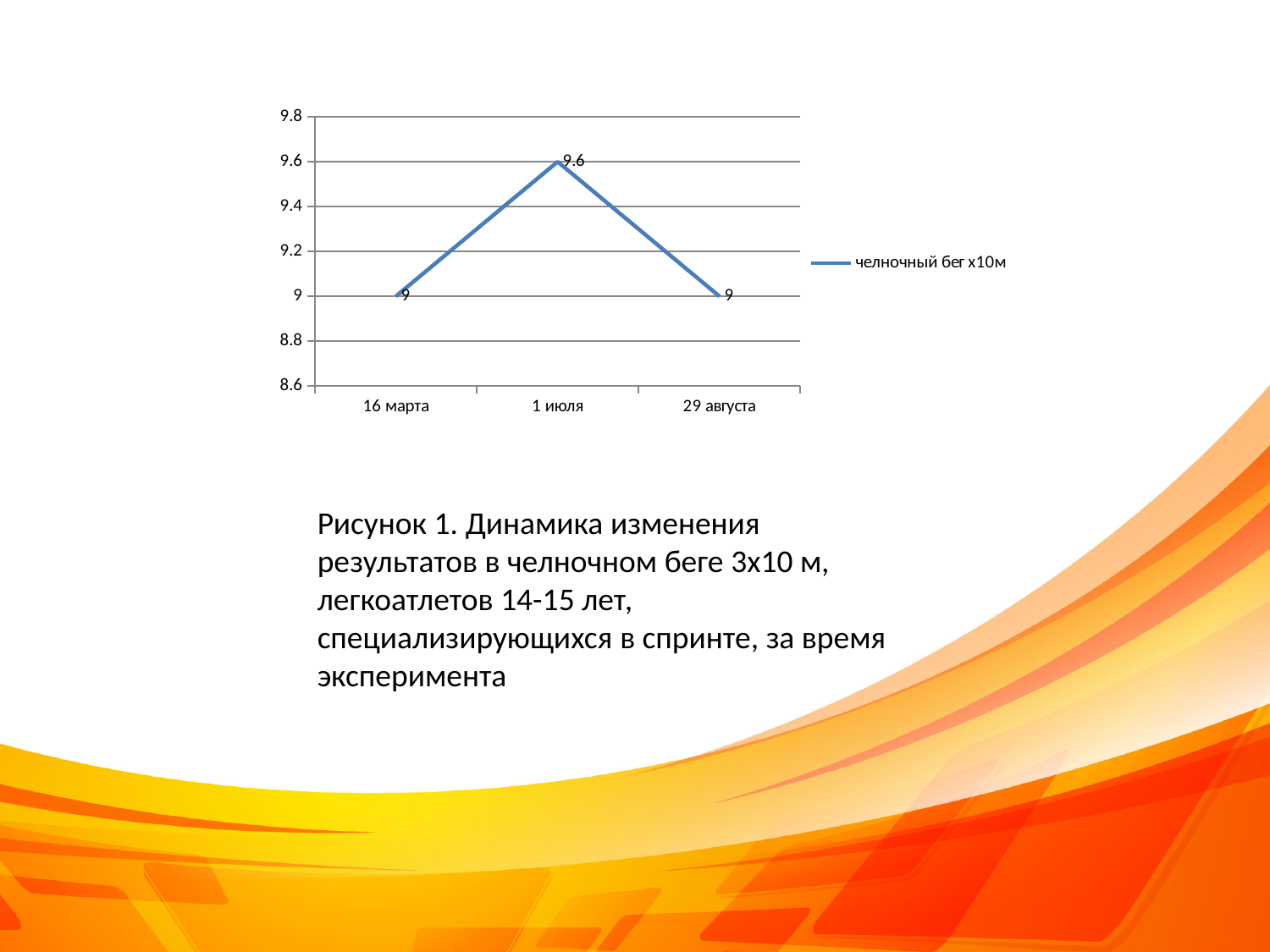
What is the value for 29 августа? 9 Which is larger, the value for 1 июля or the value for 29 августа? 1 июля Is the value for 1 июля greater or less than 9.4? greater What kind of chart is shown on the slide? line chart How many series does the legend list? 1 What is the value for 16 марта? 9 Does the value rise or fall from 1 июля to 29 августа? fall What is the value for 1 июля? 9.6 What is the name of the series in the legend? челночный бег х10м Which category has the highest value? 1 июля What is the difference between the values for 1 июля and 16 марта? 0.6 How many categories are shown on the x axis? 3